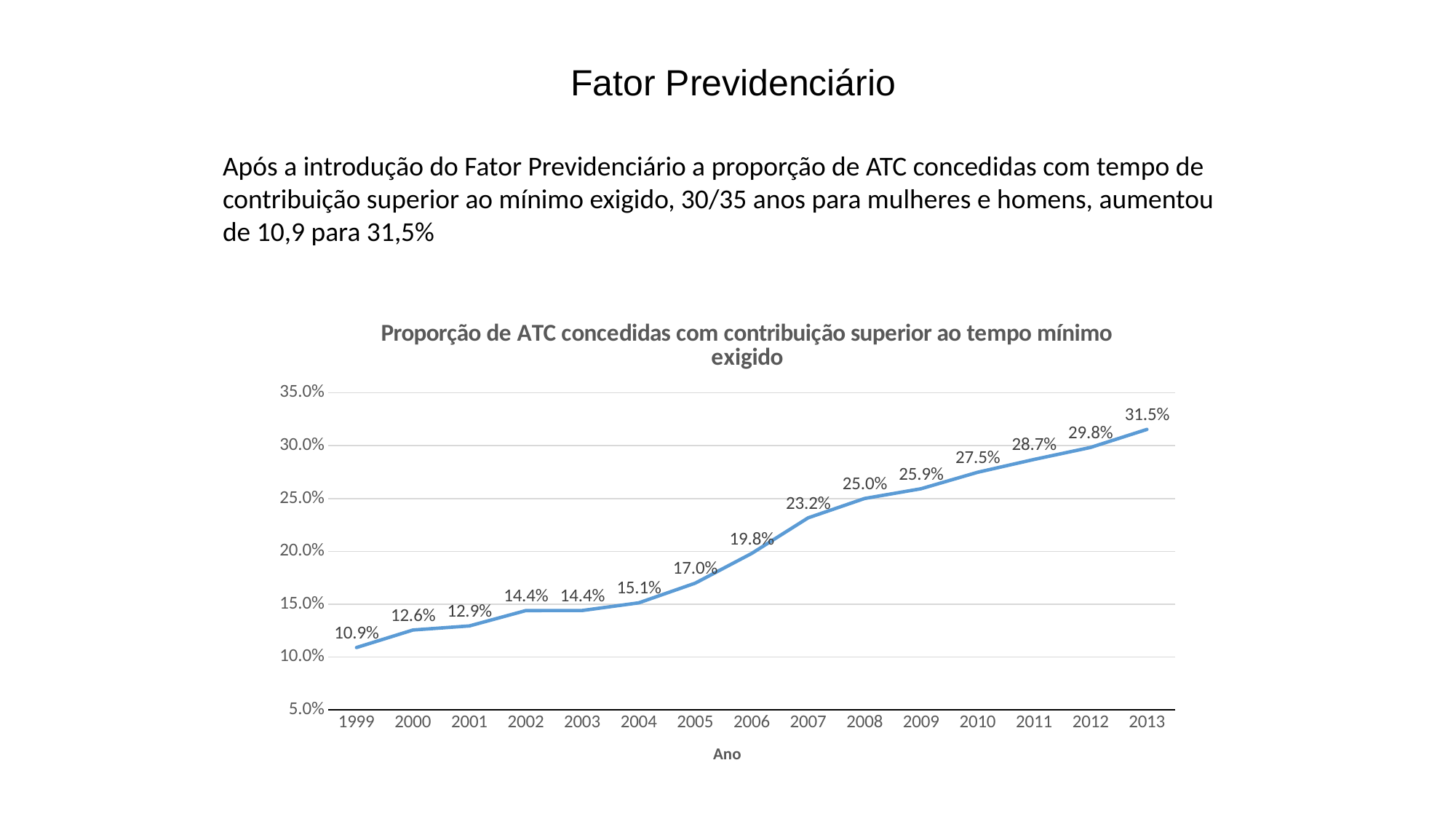
Which year has the lowest value? 1999 How many years are plotted on the x axis? 15 Which year has the highest value? 2013 Do the values rise or fall from 1999 to 2013? rise What is the difference between the values for 2013 and 1999? 20.6% What is the value for 2010? 27.5% What is the value for 2005? 17.0% Is the value for 2008 greater or less than 20.0%? greater What is the label of the x axis? Ano What kind of chart is shown? line chart What is the value for 1999? 10.9% Which is larger, the value for 2007 or the value for 2006? 2007